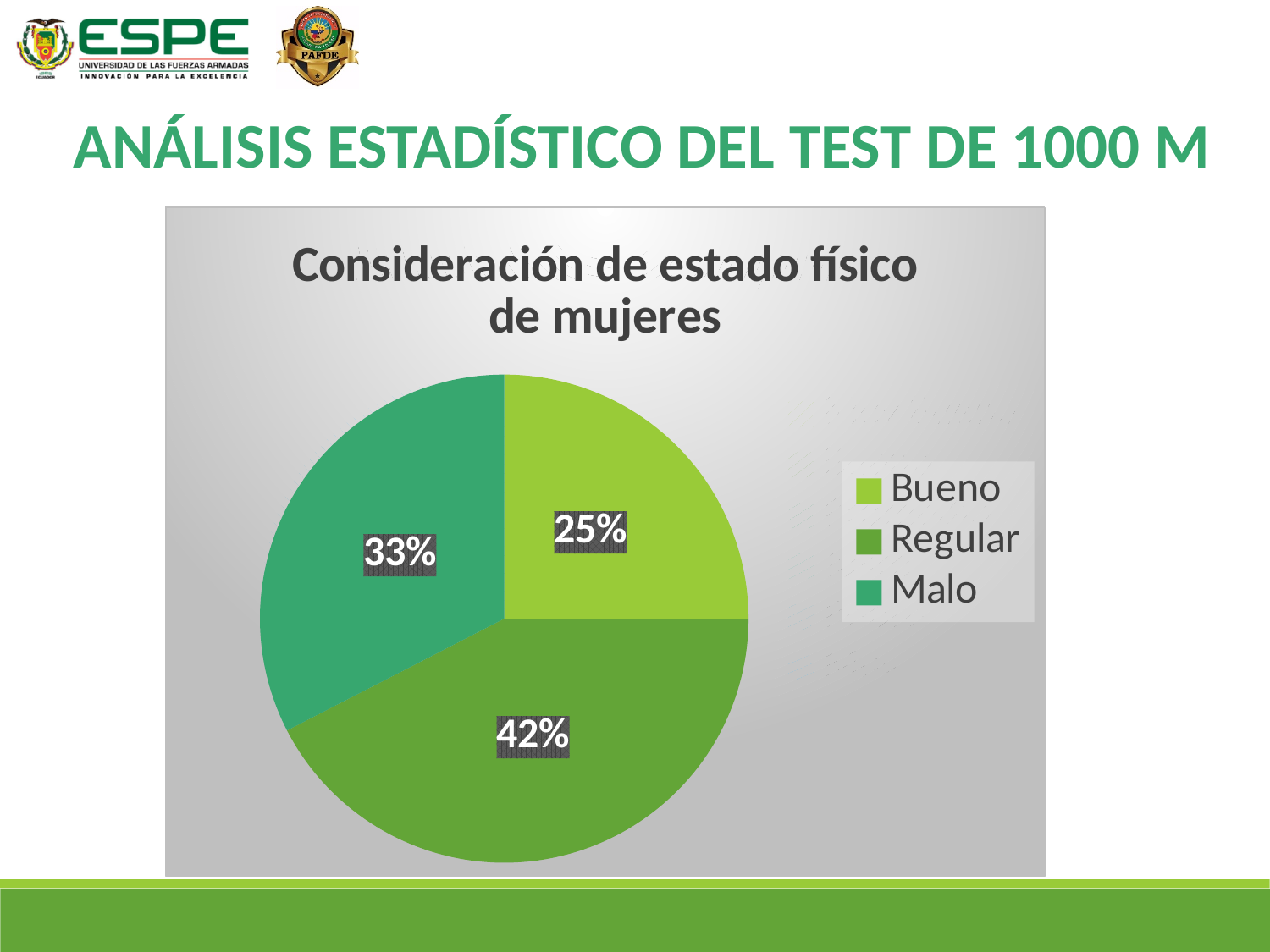
Which category has the smallest share of the pie? Bueno What is the difference in percentage points between Regular and Bueno? 17 What is the difference in percentage points between Malo and Bueno? 8 What type of chart is shown on the slide? Pie chart What percentage of the pie corresponds to Bueno? 25% What is the title of the chart? Consideración de estado físico de mujeres What percentage of the pie corresponds to Malo? 33% Which is larger, the share for Malo or the share for Bueno? Malo How many categories does the pie chart have? 3 What percentage of the pie corresponds to Regular? 42% Which category has the largest share of the pie? Regular How many entries does the legend list? 3